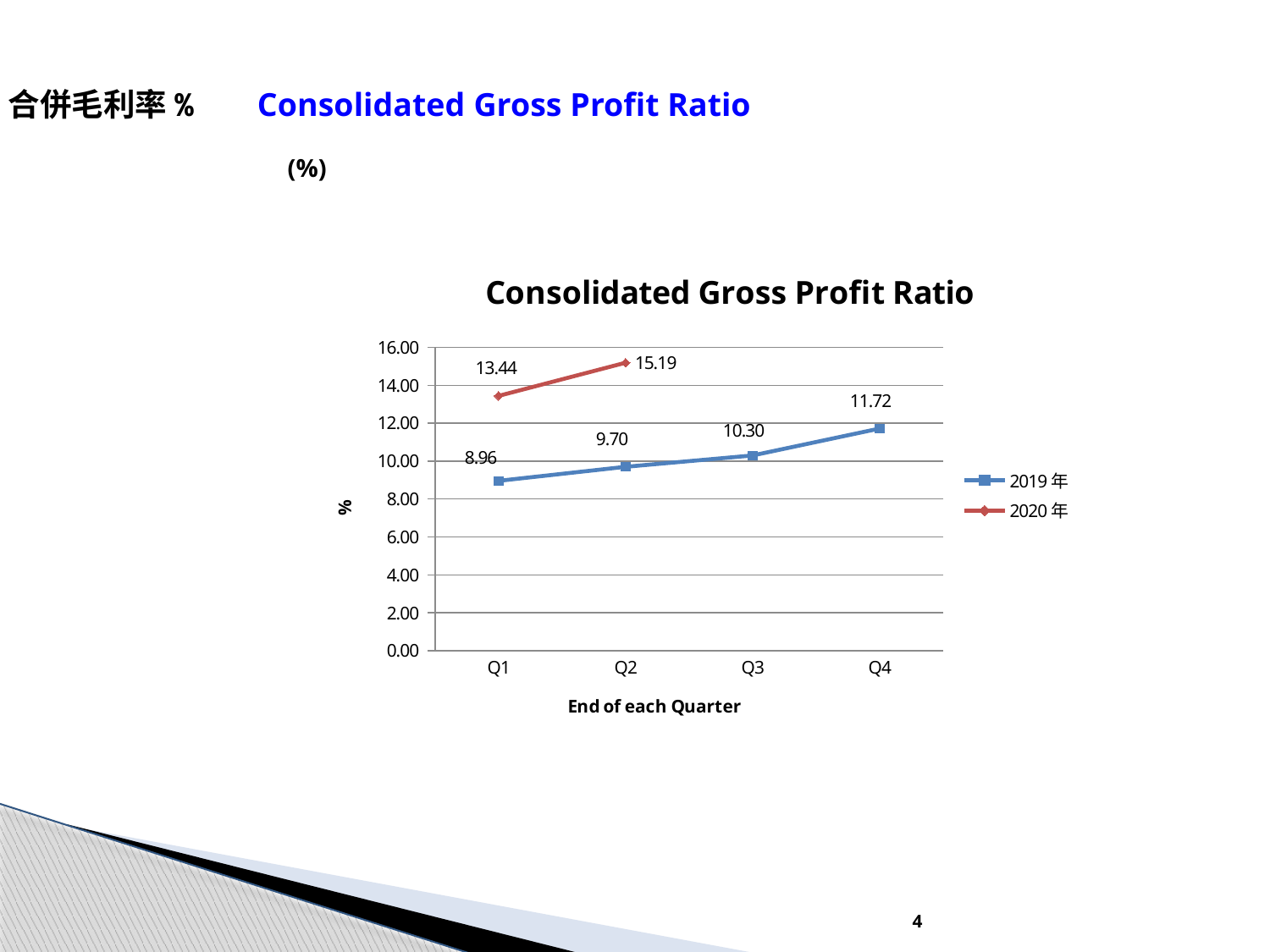
What kind of chart is shown on the slide? line chart What is the value for 2019年 in Q4? 11.72 What is the Consolidated Gross Profit Ratio for 2020年 in Q2? 15.19 Which is larger in Q2: the 2019年 value or the 2020年 value? 2020年 Is the 2019年 value in Q3 greater or less than 12.00? less Does the 2019年 series rise or fall from Q1 to Q4? rise How many series does the legend list? 2 Which quarter has the lowest value for the 2019年 series? Q1 What is the Consolidated Gross Profit Ratio for 2019年 in Q1? 8.96 Which quarter has the highest value for the 2019年 series? Q4 What is the difference between the Q4 and Q1 values for 2019年? 2.76 What is the difference between the 2020年 and 2019年 values in Q1? 4.48